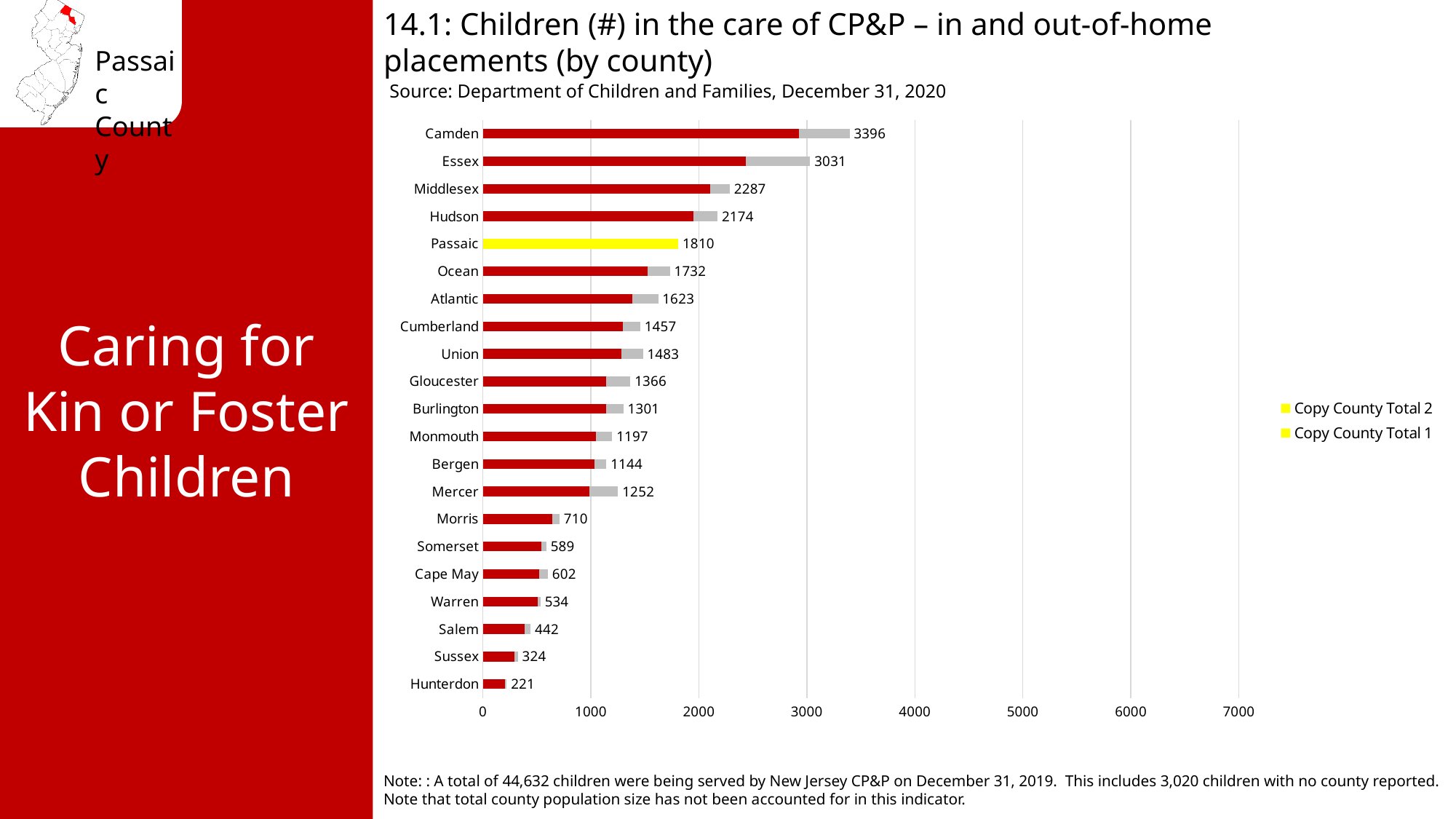
Which county has the highest labeled value? Camden What is the labeled value for Camden? 3396 How many counties are shown on the chart? 21 Which county has the lowest labeled value? Hunterdon What is the labeled value for Passaic? 1810 Which county's bar is highlighted in yellow? Passaic What kind of chart is shown? Bar chart How many series does the legend list? 2 Which has a larger labeled value, Union or Cumberland? Union What is the difference between the labeled values for Camden and Essex? 365 What is the labeled value for Hunterdon? 221 Is the labeled value for Hudson greater or less than 2000? greater